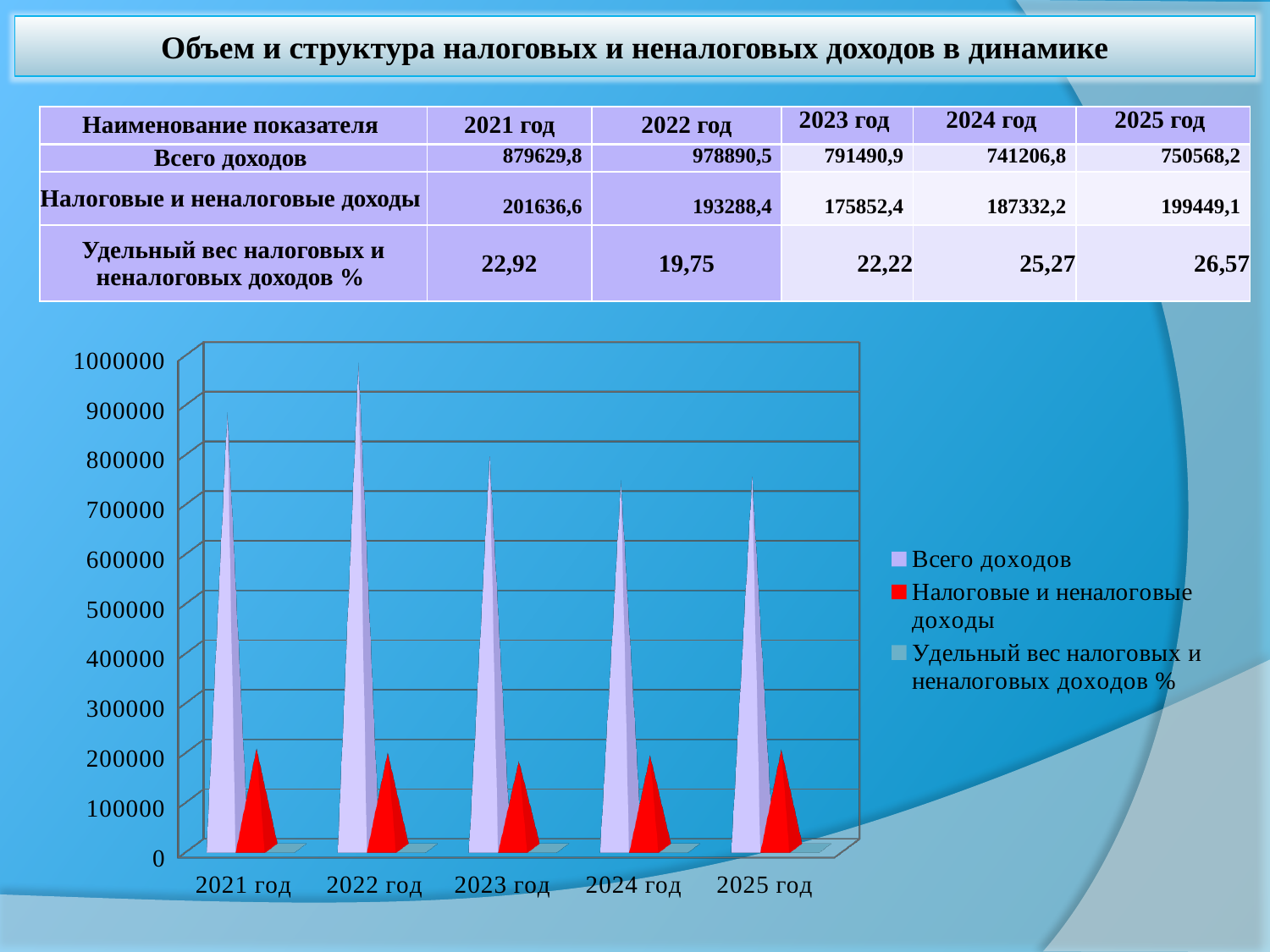
According to the table on the slide, what is the value of Всего доходов for 2022 год? 978890,5 Is the value for Всего доходов in 2024 год greater or less than 800000? less What kind of chart is shown on the slide? bar chart In which year is the value for Всего доходов the highest? 2022 год Is the value for Налоговые и неналоговые доходы in 2021 год greater or less than 300000? less Which is larger: Налоговые и неналоговые доходы in 2021 год or in 2023 год? 2021 год Using the values in the table, what is the difference between Всего доходов in 2022 год and 2021 год? 99260,7 Is the value for Всего доходов in 2022 год greater or less than 900000? greater How many year categories are shown on the x axis of the chart? 5 According to the table on the slide, what is the Удельный вес налоговых и неналоговых доходов % for 2025 год? 26,57 How many series does the chart legend list? 3 What colour represents the series Налоговые и неналоговые доходы in the chart? red